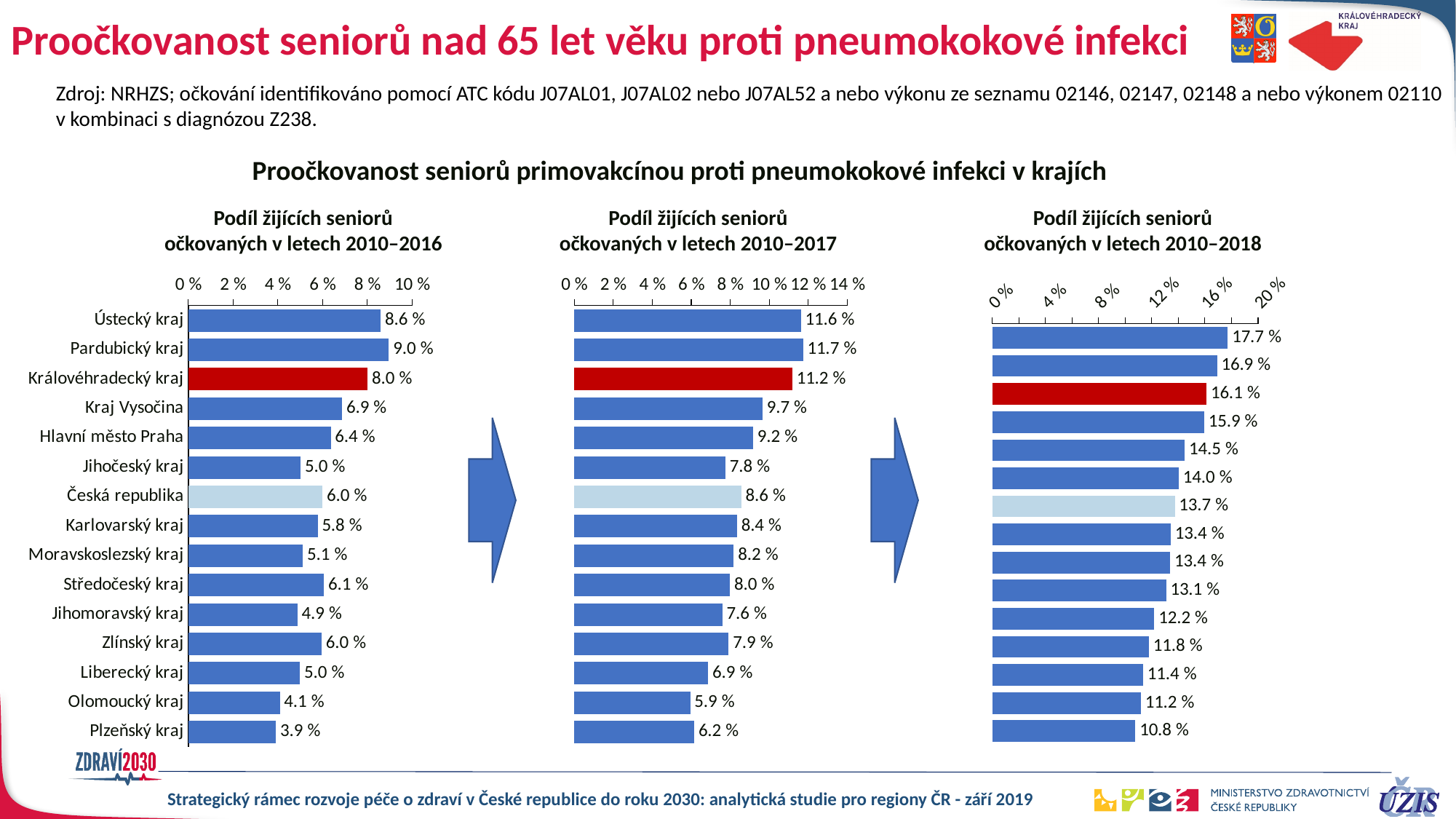
In the chart 'Podíl žijících seniorů očkovaných v letech 2010–2016', which region has the lowest value? Plzeňský kraj In the chart 'Podíl žijících seniorů očkovaných v letech 2010–2016', what is the value for Královéhradecký kraj? 8.0 % In the chart 'Podíl žijících seniorů očkovaných v letech 2010–2016', which is larger: Kraj Vysočina or Hlavní město Praha? Kraj Vysočina In the chart 'Podíl žijících seniorů očkovaných v letech 2010–2016', which region's bar is coloured red? Královéhradecký kraj In the chart 'Podíl žijících seniorů očkovaných v letech 2010–2018', is the value for the bottom bar (Plzeňský kraj) greater or less than 12 %? less In the chart 'Podíl žijících seniorů očkovaných v letech 2010–2017', what is the value for Česká republika? 8.6 % In the chart 'Podíl žijících seniorů očkovaných v letech 2010–2017', which region has the lowest value? Olomoucký kraj In the chart 'Podíl žijících seniorů očkovaných v letech 2010–2017', what is the difference between Pardubický kraj and Královéhradecký kraj? 0.5 % In the chart 'Podíl žijících seniorů očkovaných v letech 2010–2016', which region has the highest value? Pardubický kraj In the chart 'Podíl žijících seniorů očkovaných v letech 2010–2018', what is the value for the row Ústecký kraj (the top bar)? 17.7 % What type of chart is used for 'Podíl žijících seniorů očkovaných v letech 2010–2018'? Bar chart How many bars does the chart 'Podíl žijících seniorů očkovaných v letech 2010–2016' contain? 15